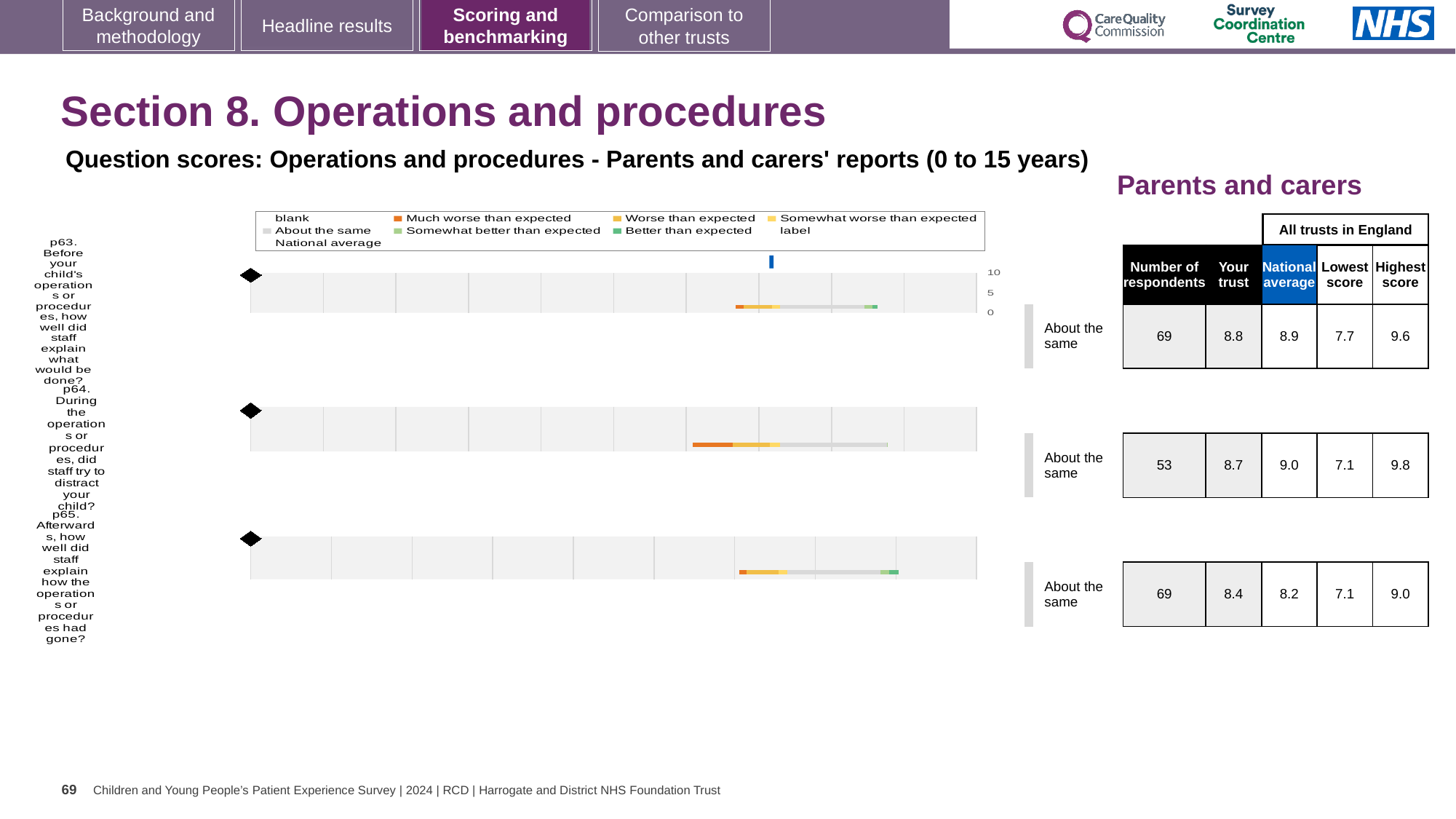
For p64, which is larger: the 'Your trust' score or the national average? National average How many questions (p63, p64, p65) are plotted in the chart? 3 Is the 'Your trust' score for p65 greater or less than 5 on the chart axis? greater What is the 'Your trust' score for p64 (During the operations or procedures, did staff try to distract your child?)? 8.7 What is the national average score for p65 (Afterwards, how well did staff explain how the operations or procedures had gone?)? 8.2 What type of chart is used to show the question scores on this slide? bar chart What is the number of respondents for p63 (Before your child's operations or procedures, how well did staff explain what would be done?)? 69 Which question has the lowest 'Your trust' score? p65 What is the highest score among all trusts in England for p64? 9.8 Which question has the highest 'Your trust' score? p63 What benchmarking category is shown for all three questions on this slide? About the same What is the difference between the highest score and the lowest score for p63? 1.9